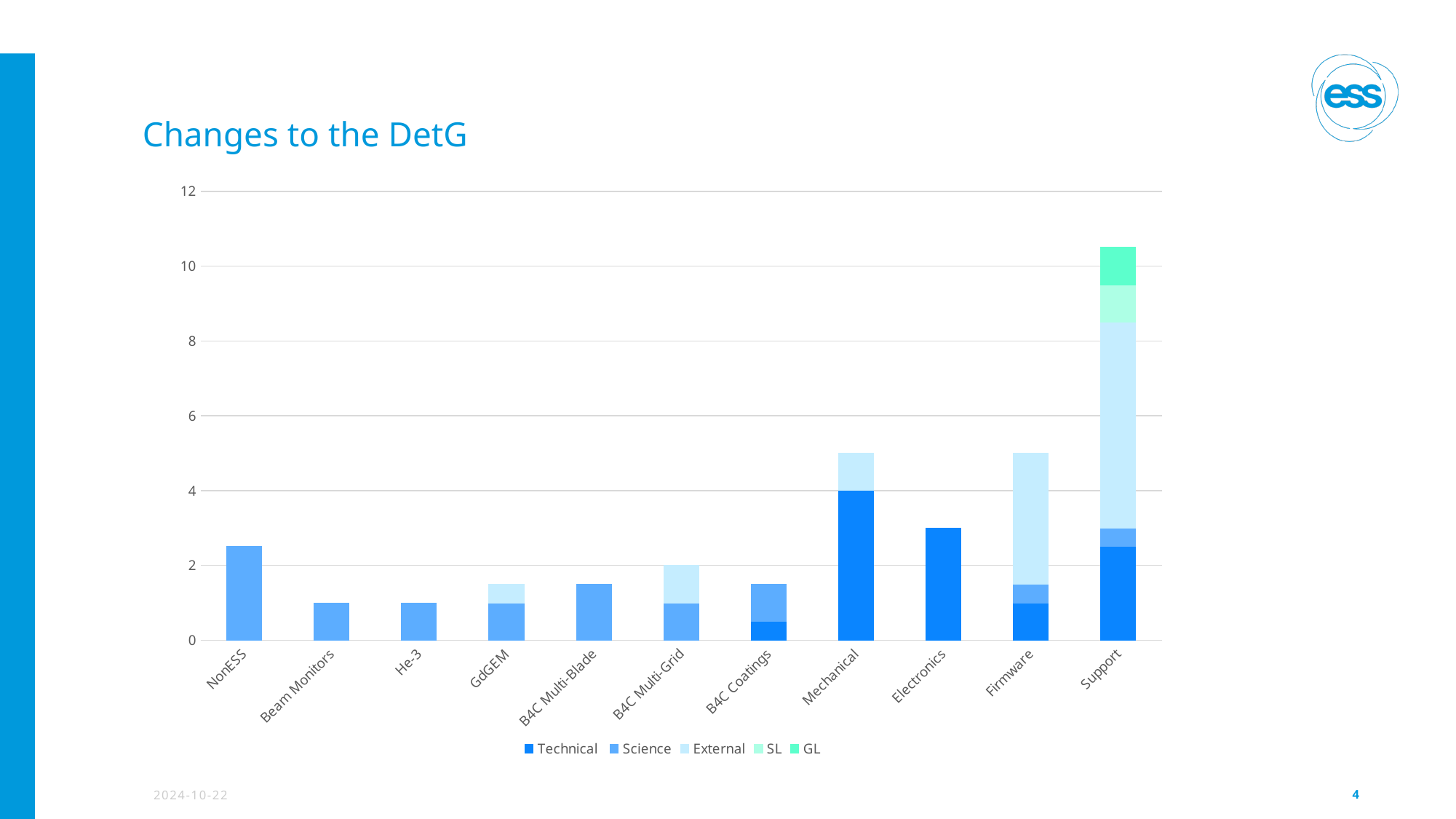
How many series does the legend list? 5 Which category is the only one with a GL segment? Support Is the total for Support greater or less than 10? greater What kind of chart is shown on the slide? Stacked bar chart Which category has the highest total bar? Support How many categories are shown on the x axis? 11 Which has the larger total bar, Firmware or Electronics? Firmware Is the total for Electronics greater or less than 4? less What is the title of the chart? Changes to the DetG What is the total of the stacked bar for B4C Multi-Grid? 2 What is the Technical value for Mechanical? 4 Is the total for NonESS greater or less than 2? greater